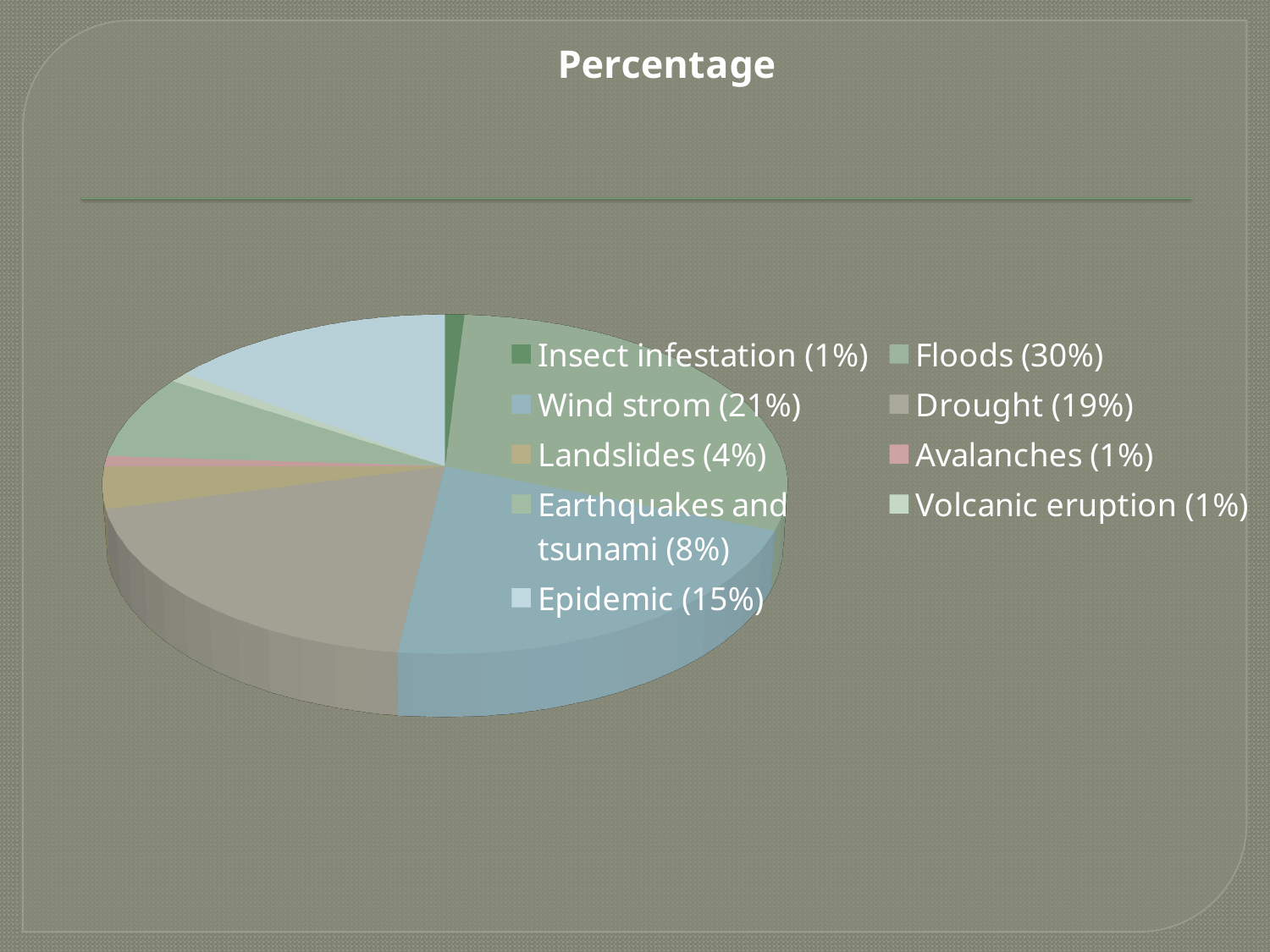
Which is larger, the share for Drought or the share for Epidemic? Drought What type of chart is shown on the slide? pie chart What is the combined share of Floods and Wind strom? 51% What percentage is shown for Floods? 30% What is the title of the chart? Percentage What share of the pie does Epidemic represent? 15% What percentage is shown for Earthquakes and tsunami? 8% What is the difference between the Floods share and the Wind strom share? 9% What percentage is shown for Landslides? 4% How many categories does the pie chart's legend list? 9 Which category has the largest share of the pie? Floods What percentage is shown for Wind strom? 21%